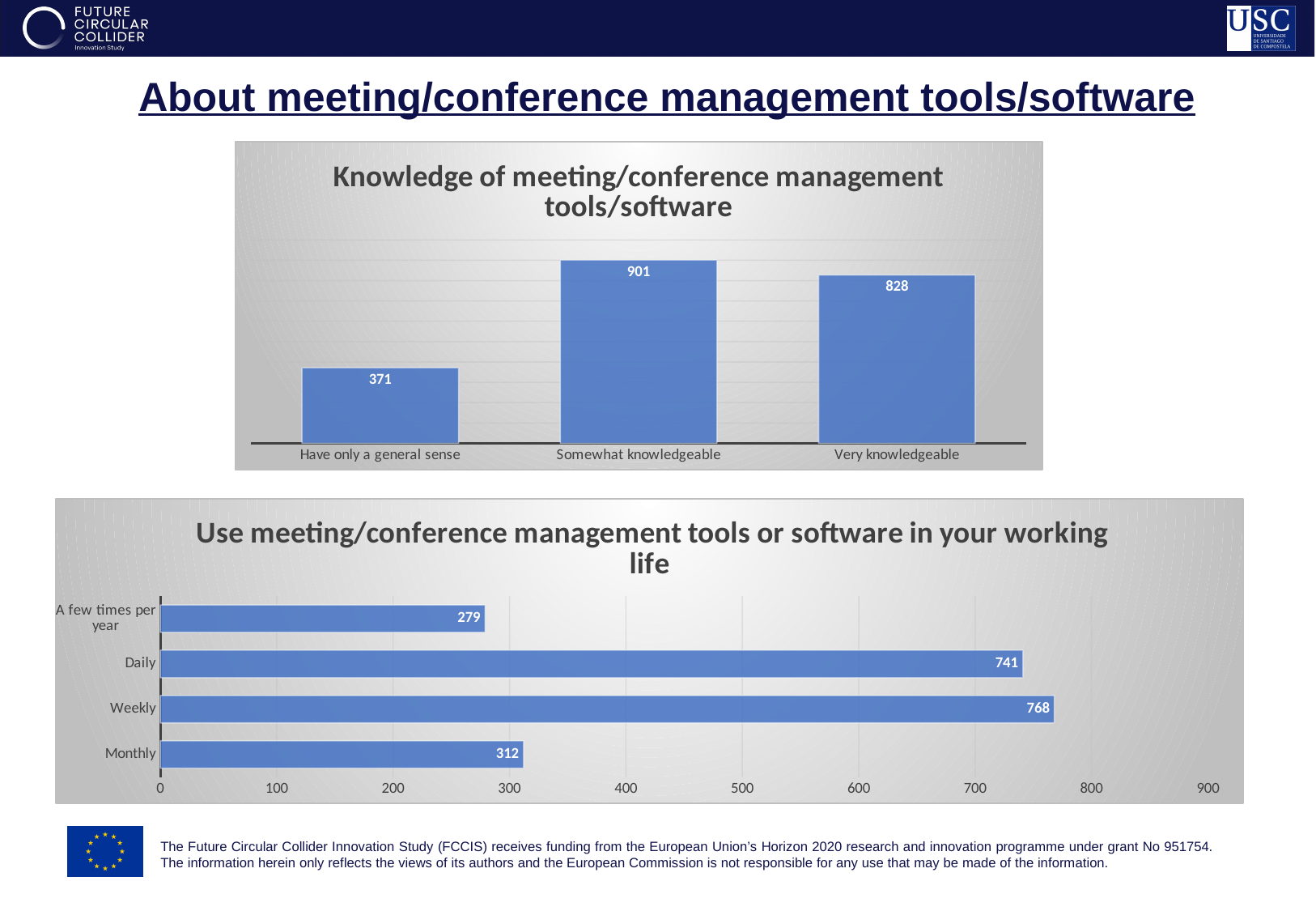
In the 'Use meeting/conference management tools or software in your working life' chart, is the value for 'Daily' greater or less than 700? greater In the 'Use meeting/conference management tools or software in your working life' chart, which category has the highest value? Weekly What type of chart is the 'Use meeting/conference management tools or software in your working life' chart? Bar chart In the 'Knowledge of meeting/conference management tools/software' chart, which category has the lowest value? Have only a general sense In the 'Knowledge of meeting/conference management tools/software' chart, what is the value for 'Somewhat knowledgeable'? 901 In the 'Use meeting/conference management tools or software in your working life' chart, what is the difference between 'Weekly' and 'Daily'? 27 In the 'Knowledge of meeting/conference management tools/software' chart, what is the value for 'Have only a general sense'? 371 In the 'Use meeting/conference management tools or software in your working life' chart, which is larger, 'Monthly' or 'A few times per year'? Monthly In the 'Use meeting/conference management tools or software in your working life' chart, what is the value for 'Weekly'? 768 In the 'Use meeting/conference management tools or software in your working life' chart, which category has the lowest value? A few times per year In the 'Knowledge of meeting/conference management tools/software' chart, what is the difference between 'Somewhat knowledgeable' and 'Very knowledgeable'? 73 In the 'Knowledge of meeting/conference management tools/software' chart, how many categories are shown? 3